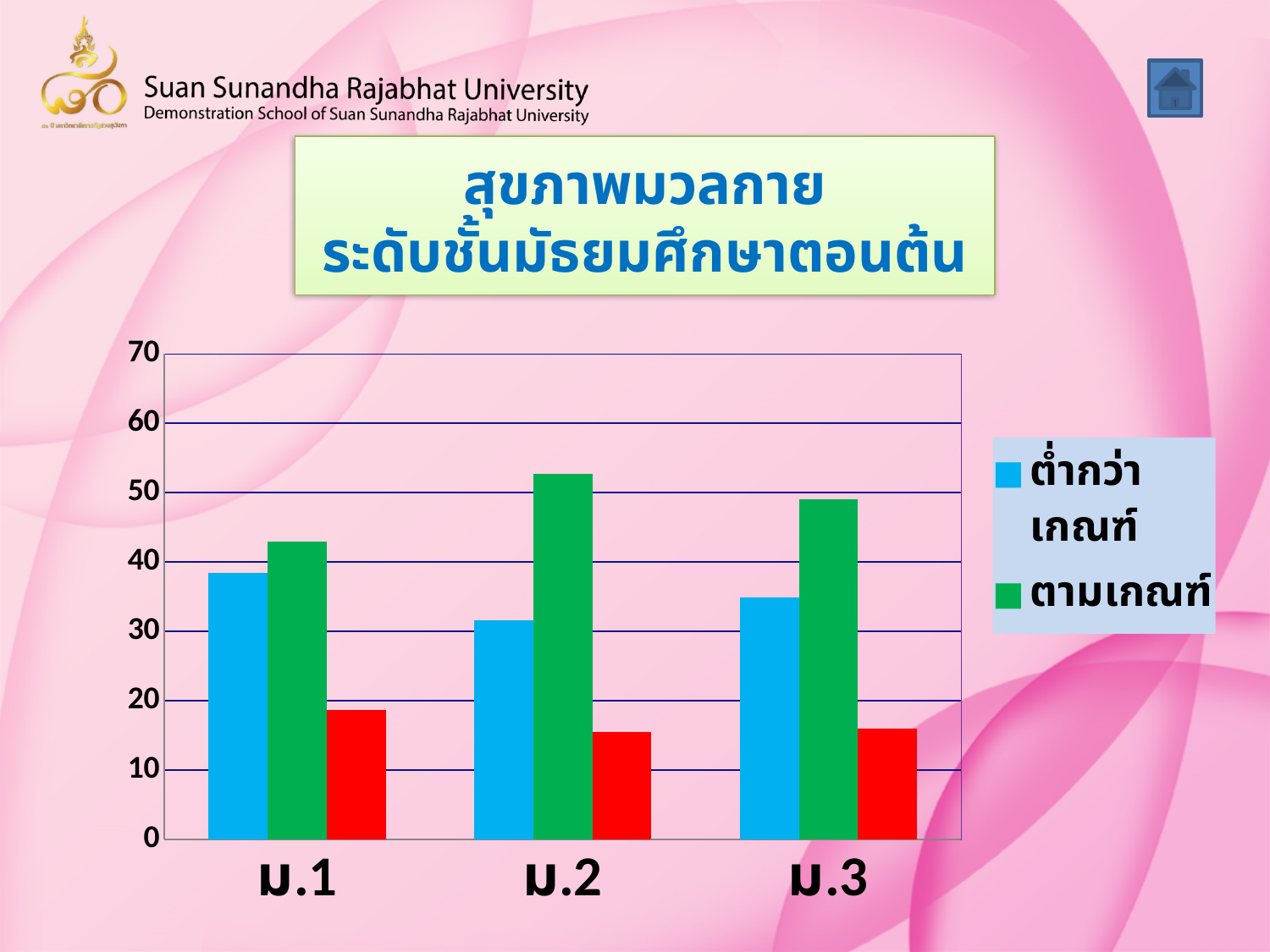
Is the value for ตามเกณฑ์ in ม.2 greater or less than 50? greater Is the value for ต่ำกว่าเกณฑ์ in ม.2 greater or less than 40? less Which category has the highest value for ตามเกณฑ์? ม.2 Which category has the highest value for ต่ำกว่าเกณฑ์? ม.1 Which colour represents ตามเกณฑ์ in the chart's legend? green How many categories are shown on the x axis of the chart? 3 Which category has the lowest value for ต่ำกว่าเกณฑ์? ม.2 Which category has the lowest value for ตามเกณฑ์? ม.1 How many series does the chart's legend list? 2 What kind of chart is shown on the slide? bar chart In ม.1, which is larger: ต่ำกว่าเกณฑ์ or ตามเกณฑ์? ตามเกณฑ์ Is the value for ตามเกณฑ์ in ม.3 greater or less than 40? greater